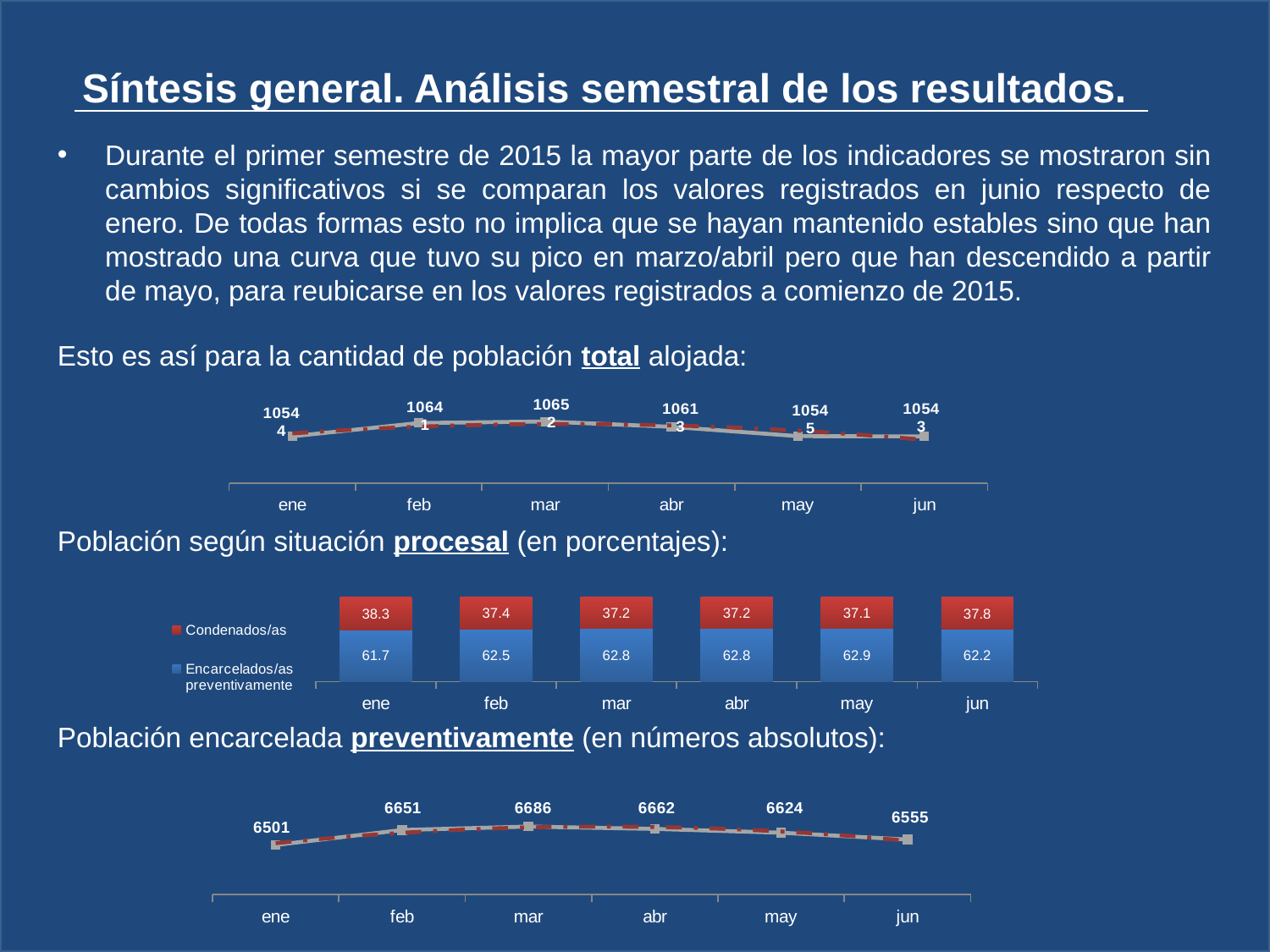
In the bottom chart (Población encarcelada preventivamente), what is the value for ene? 6501 In the middle chart (Población según situación procesal), what is the total of the stacked bar for jun? 100 In the bottom chart (Población encarcelada preventivamente), what is the value for mar? 6686 In the bottom chart (Población encarcelada preventivamente), which month has the highest value? mar In the bottom chart (Población encarcelada preventivamente), which is larger, the value for abr or the value for jun? abr In the middle chart (Población según situación procesal), what is the Encarcelados/as preventivamente value for may? 62.9 What kind of chart is the top chart (población total alojada)? line chart In the bottom chart (Población encarcelada preventivamente), what is the difference between the values for feb and ene? 150 In the middle chart (Población según situación procesal), how many series does the legend list? 2 How many months are plotted on the x axis of the top chart (población total alojada)? 6 In the bottom chart (Población encarcelada preventivamente), which month has the lowest value? ene In the middle chart (Población según situación procesal), what is the Condenados/as value for ene? 38.3